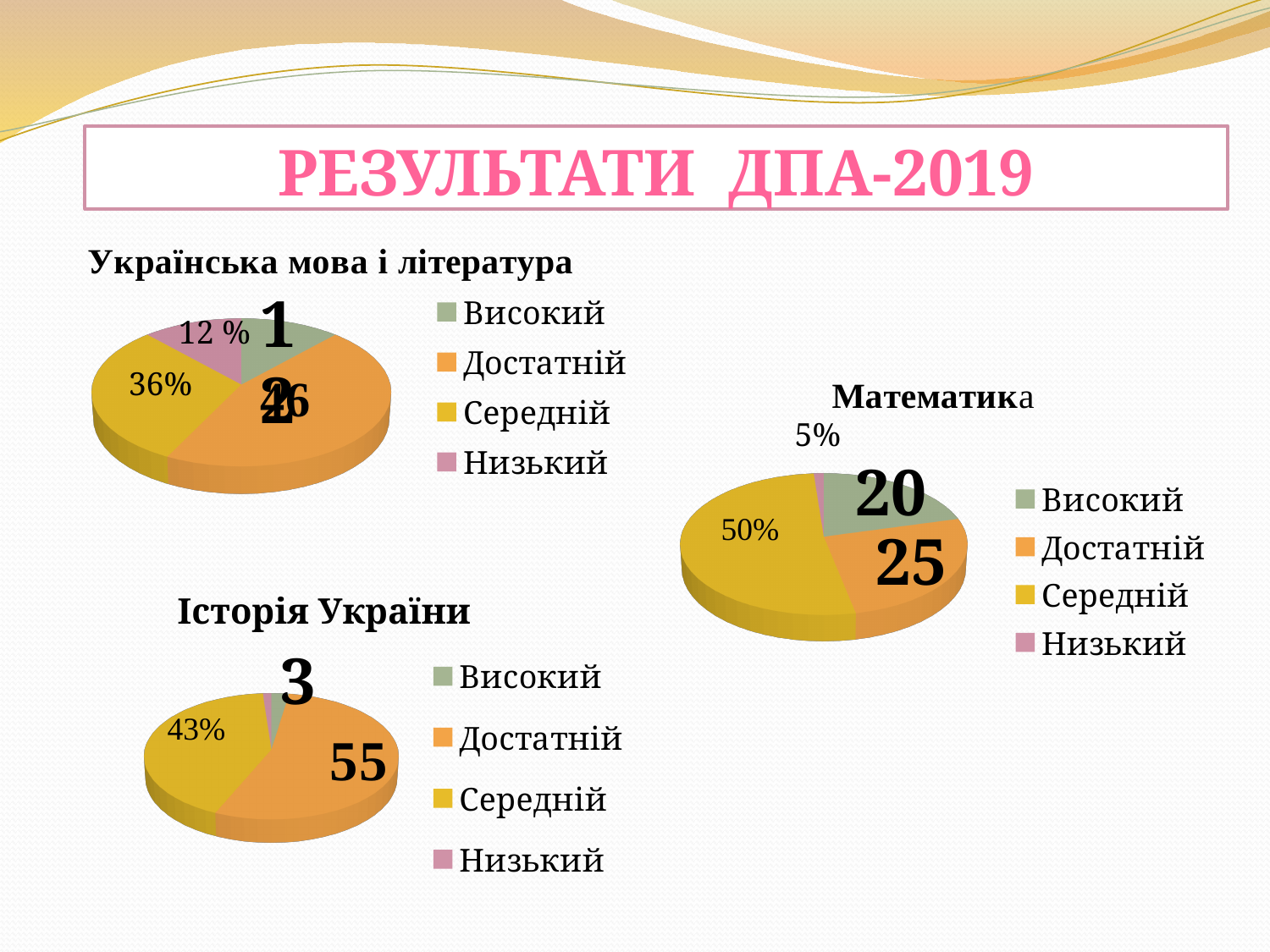
In the "Математика" chart, what is the value shown for Низький? 5% In the "Математика" chart, what is the value shown for Середній? 50% In the "Історія України" chart, which category has the largest slice? Достатній How many entries does the legend of the "Історія України" chart list? 4 In the "Історія України" chart, what value is printed on the Достатній slice? 55 In the "Історія України" chart, what is the value shown for Середній? 43% What kind of chart is the "Математика" chart? pie chart In the "Математика" chart, what value is printed on the Високий slice? 20 In the "Математика" chart, which is larger, Середній or Низький? Середній In the "Українська мова і література" chart, what is the value shown for Середній? 36% How many pie charts are shown on the slide? 3 In the "Українська мова і література" chart, what is the value shown for Низький? 12 %